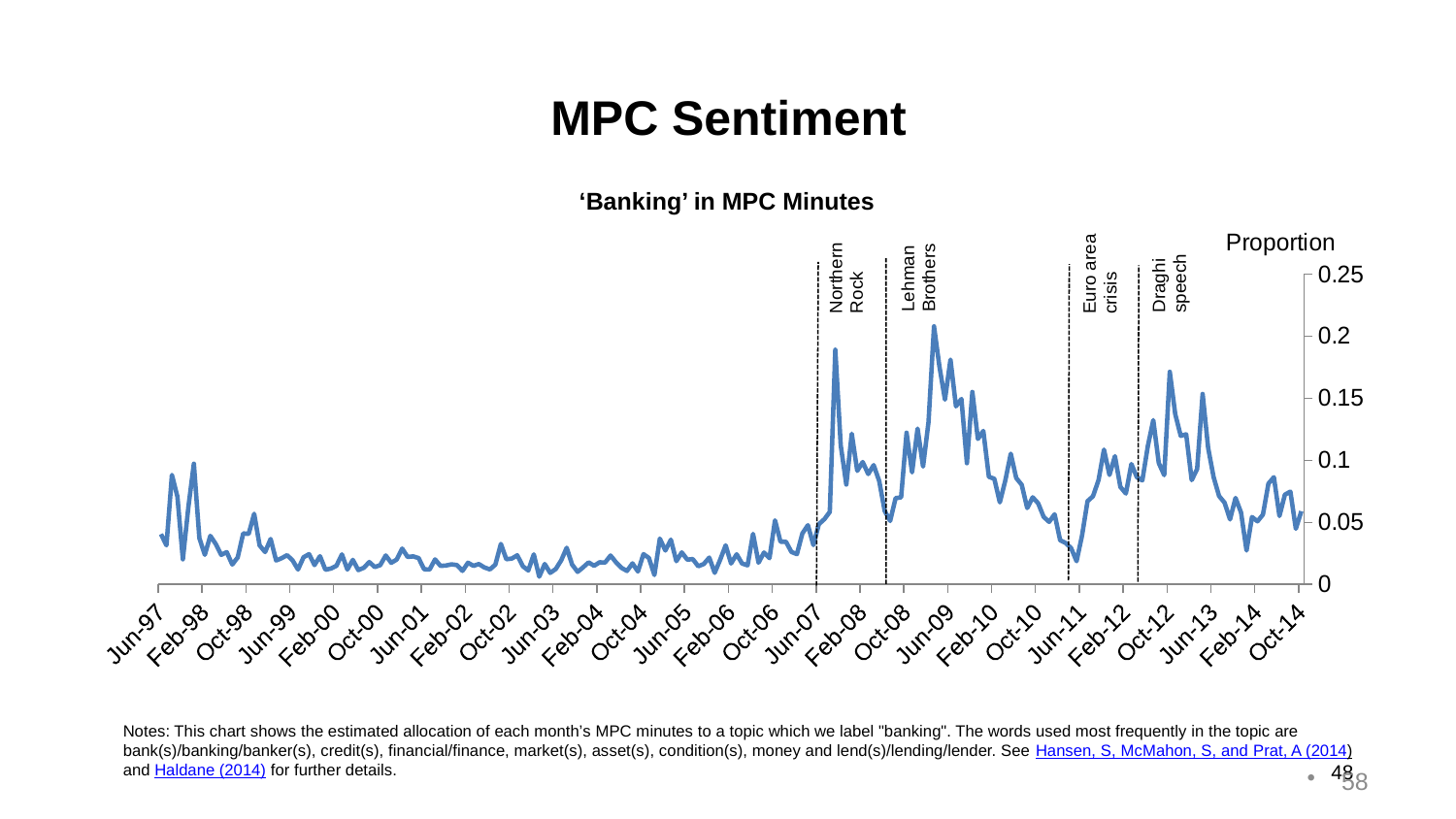
What label is given to the vertical axis of the chart? Proportion What is the highest value shown on the vertical axis? 0.25 How many event markers (dashed vertical lines) are annotated on the chart? 4 Is the value of the line around Jun-03 greater or less than 0.05? less What kind of chart is shown on the slide? Line chart Is the highest peak of the line, reached shortly after the Lehman Brothers marker, greater or less than 0.2? greater Between Jun-09 and Jun-11, does the line generally rise or fall? fall Near which annotated event does the line reach its highest value? Lehman Brothers Is the peak of the line just after the Draghi speech marker greater or less than 0.15? greater What is the title of the chart? 'Banking' in MPC Minutes